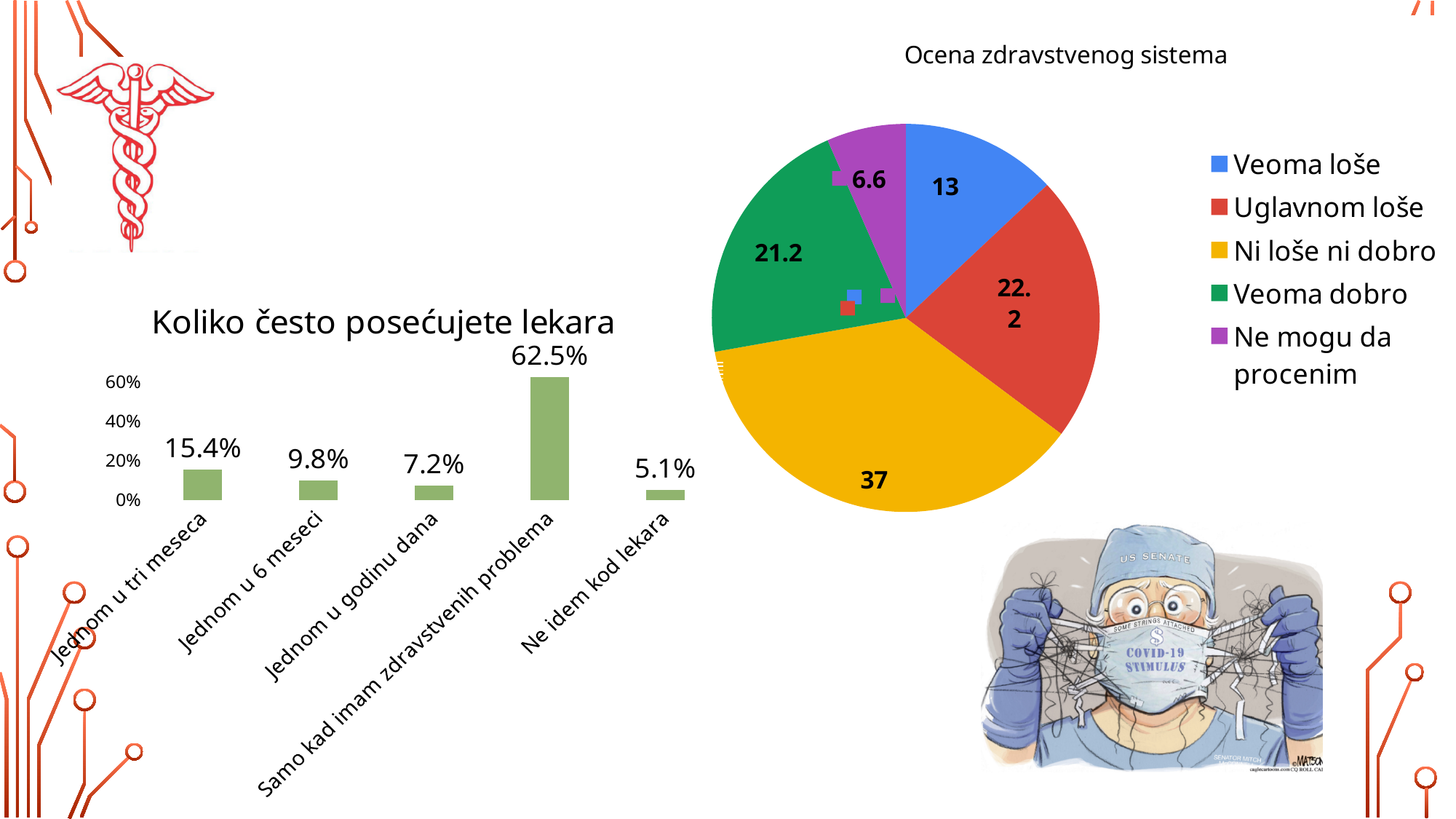
In the chart titled "Koliko često posećujete lekara", which category has the lowest value? Ne idem kod lekara How many entries does the legend of the chart titled "Ocena zdravstvenog sistema" list? 5 In the chart titled "Koliko često posećujete lekara", which category has the highest value? Samo kad imam zdravstvenih problema In the chart titled "Koliko često posećujete lekara", what is the value for "Jednom u tri meseca"? 15.4% In the chart titled "Koliko često posećujete lekara", how many categories are shown? 5 What kind of chart is the one titled "Koliko često posećujete lekara"? Bar chart In the chart titled "Ocena zdravstvenog sistema", what is the value for "Ne mogu da procenim"? 6.6 In the chart titled "Koliko često posećujete lekara", what is the difference between "Jednom u 6 meseci" and "Jednom u godinu dana"? 2.6% In the chart titled "Ocena zdravstvenog sistema", which category has the largest slice? Ni loše ni dobro In the chart titled "Ocena zdravstvenog sistema", which is larger: "Uglavnom loše" or "Veoma dobro"? Uglavnom loše What kind of chart is the one titled "Ocena zdravstvenog sistema"? Pie chart In the chart titled "Ocena zdravstvenog sistema", what is the value for "Ni loše ni dobro"? 37